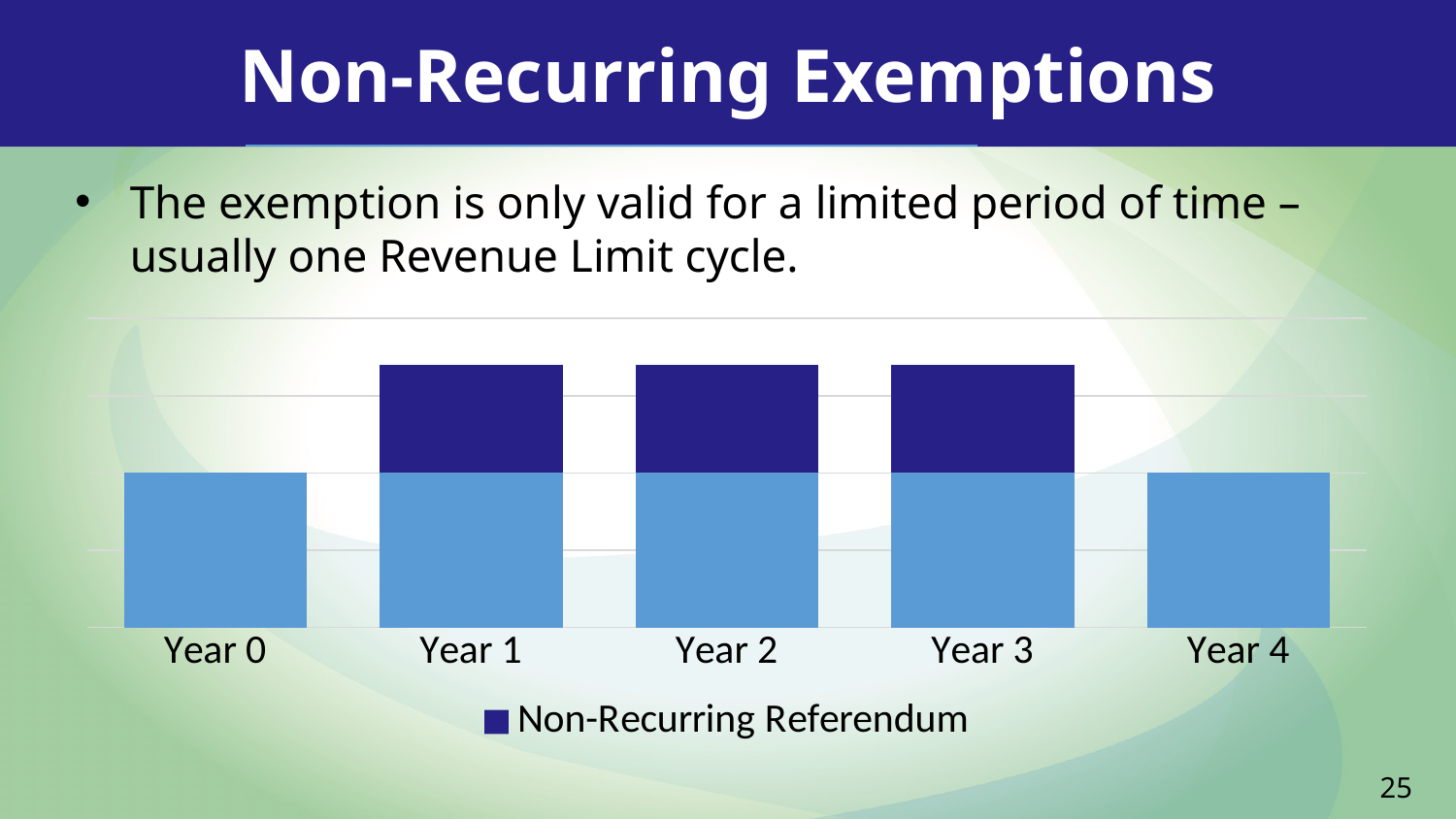
How many bars include a dark blue Non-Recurring Referendum segment? 3 How many categories are shown on the x axis of the chart? 5 Does the bar height rise or fall from Year 3 to Year 4? fall What is the legend entry shown below the chart? Non-Recurring Referendum How many series does the chart's legend list? 1 Does the bar height rise or fall from Year 0 to Year 1? rise Which is taller, the bar for Year 1 or the bar for Year 0? Year 1 Which years have a dark blue Non-Recurring Referendum segment on top of their bar? Year 1, Year 2, Year 3 Which is taller, the bar for Year 3 or the bar for Year 4? Year 3 What kind of chart is shown on the slide? Stacked bar chart What is the label of the first category on the x axis? Year 0